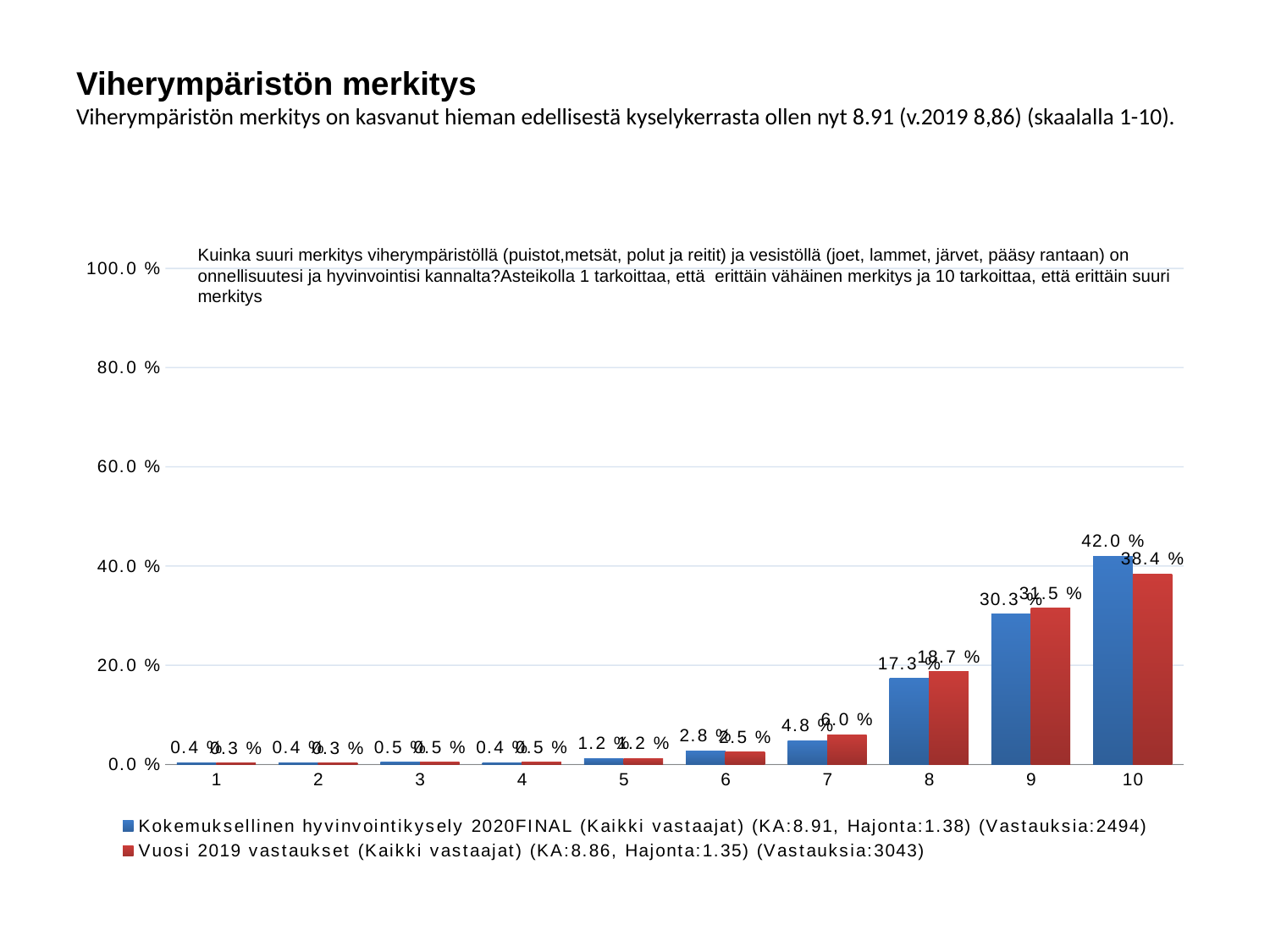
How many series does the legend list? 2 Is the 2020 value for category 10 greater or less than 40.0 %? greater What is the value for category 10 in the 2020 series (Kokemuksellinen hyvinvointikysely 2020FINAL)? 42.0 % What is the value for category 8 in the Vuosi 2019 vastaukset series? 18.7 % How many categories are shown on the x axis? 10 For category 9, which series has the larger value, 2020 or 2019? 2019 (Vuosi 2019 vastaukset) What is the value for category 7 in the 2020 series (Kokemuksellinen hyvinvointikysely 2020FINAL)? 4.8 % What is the value for category 10 in the Vuosi 2019 vastaukset series? 38.4 % Do the values in the 2020 series generally rise or fall from category 1 to category 10? Rise Which category has the highest value in the 2020 series? 10 What kind of chart is shown on the slide? Bar chart What is the difference between the 2020 and 2019 values for category 10? 3.6 %